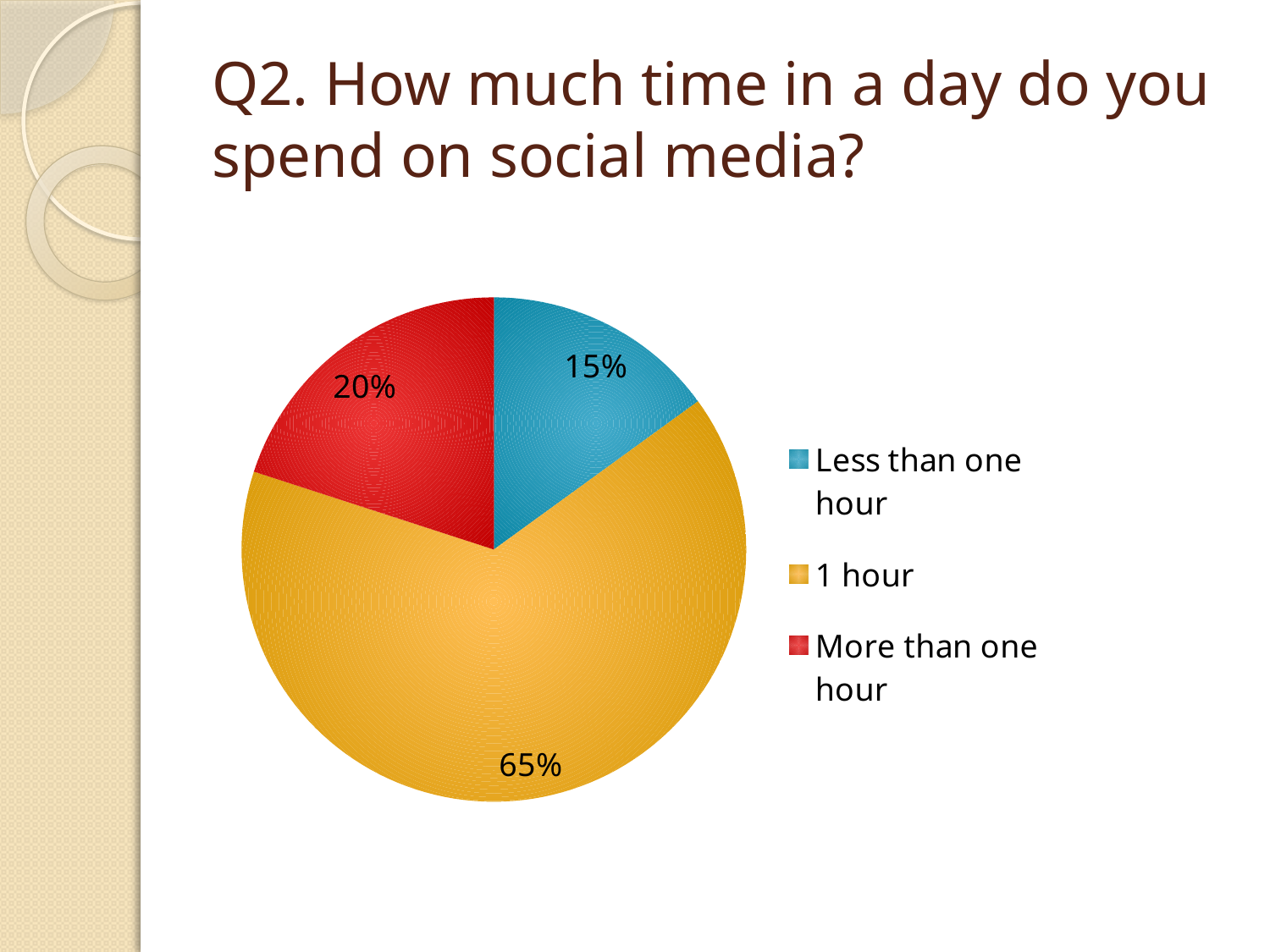
What colour is the slice for "More than one hour"? red Which is larger, the "More than one hour" slice or the "Less than one hour" slice? More than one hour What share of the pie is labelled for "Less than one hour"? 15% What share of the pie is labelled for "More than one hour"? 20% How many entries does the legend list? 3 Which category has the largest slice of the pie? 1 hour What is the difference in percentage points between the "1 hour" slice and the "More than one hour" slice? 45 How many slices does the pie chart have? 3 Which category has the smallest slice of the pie? Less than one hour What share of the pie is labelled for "1 hour"? 65% What is the title of the slide containing the pie chart? Q2. How much time in a day do you spend on social media? What kind of chart is shown on the slide? pie chart